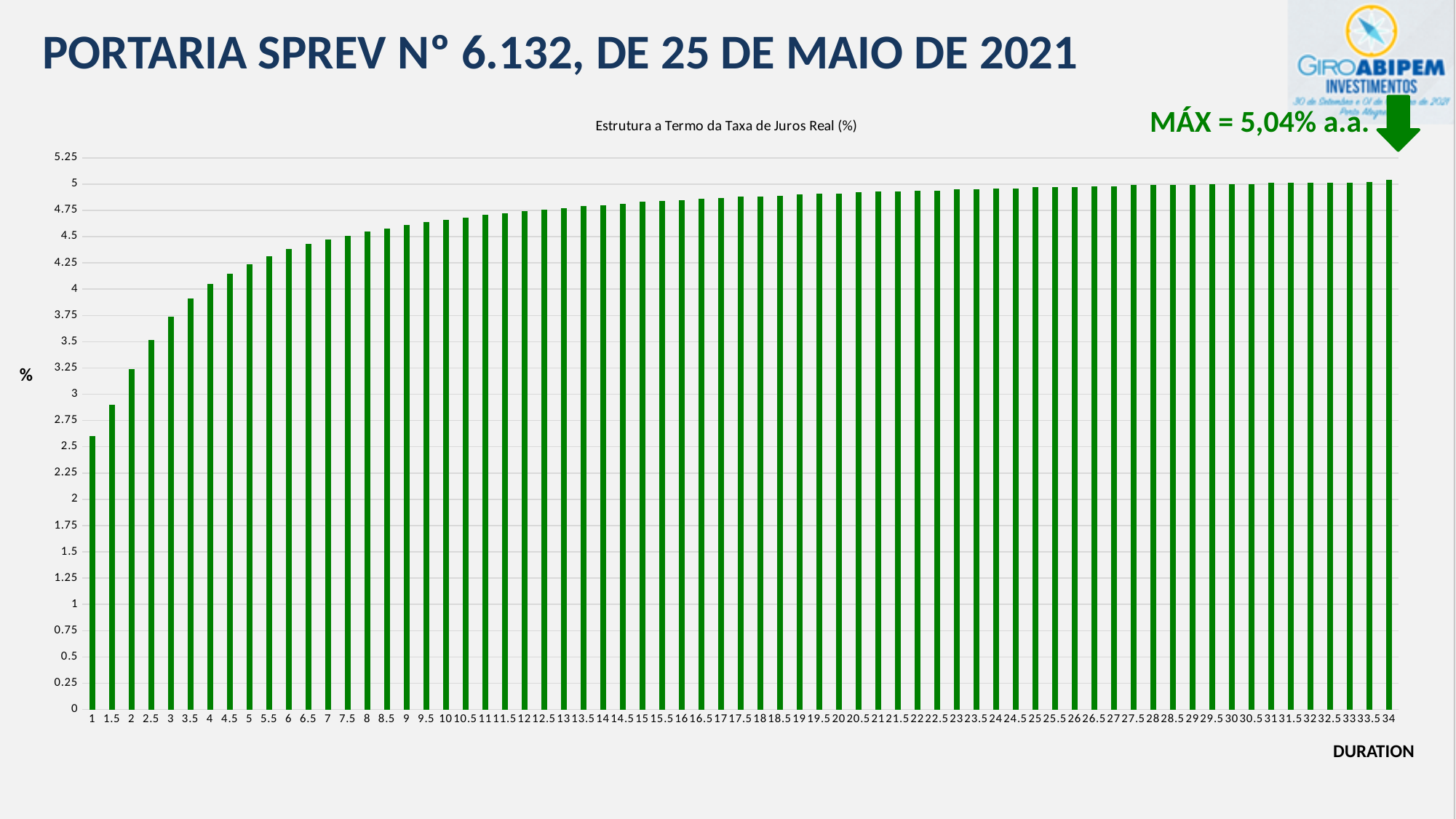
What is the label of the x axis of the chart? DURATION Is the value for duration 20 greater or less than 5? less Do the values rise or fall as duration increases along the x axis? Rise Which is larger, the value for duration 2 or the value for duration 3? Duration 3 Is the value for duration 3 greater or less than 3.5? greater How many bars are plotted in the chart? 67 Which duration has the highest value in the chart? 34 Is the value for duration 1 greater or less than 3? less What maximum value is indicated on the slide for the chart? 5,04% a.a. What is the title of the chart? Estrutura a Termo da Taxa de Juros Real (%) Which duration has the lowest value in the chart? 1 What kind of chart is shown on the slide? Bar chart